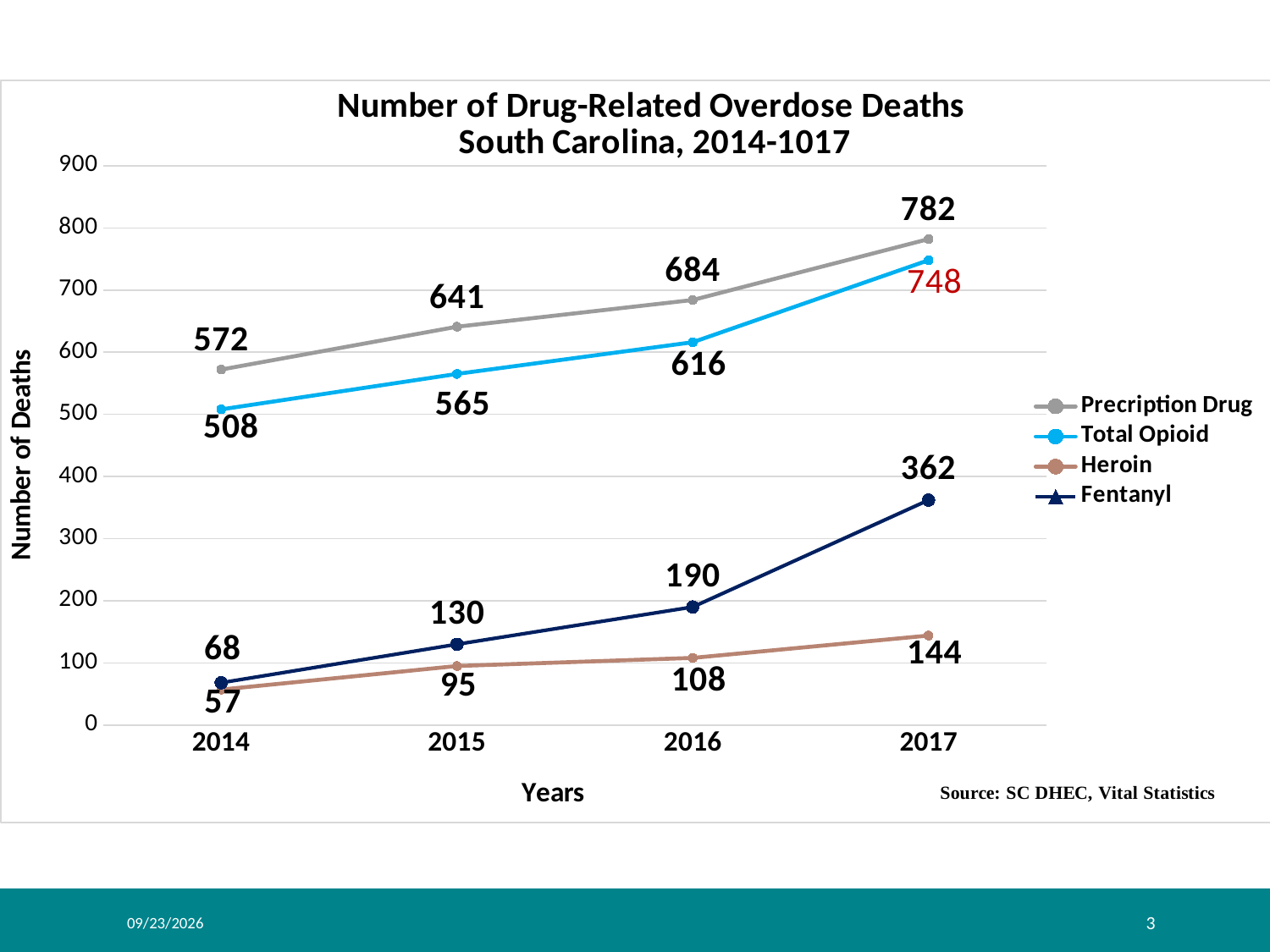
What is the number of Heroin overdose deaths in 2015? 95 What kind of chart is shown on the slide? Line chart What is the number of Prescription Drug overdose deaths in 2017? 782 What is the number of Total Opioid overdose deaths in 2014? 508 In which year were Heroin overdose deaths lowest? 2014 How many series does the legend list? 4 What is the difference between Prescription Drug and Total Opioid overdose deaths in 2016? 68 In which year were Fentanyl overdose deaths highest? 2017 How many years are shown on the x axis? 4 Do Total Opioid overdose deaths rise or fall from 2014 to 2017? Rise What is the number of Fentanyl overdose deaths in 2016? 190 Which had more overdose deaths in 2017, Fentanyl or Heroin? Fentanyl